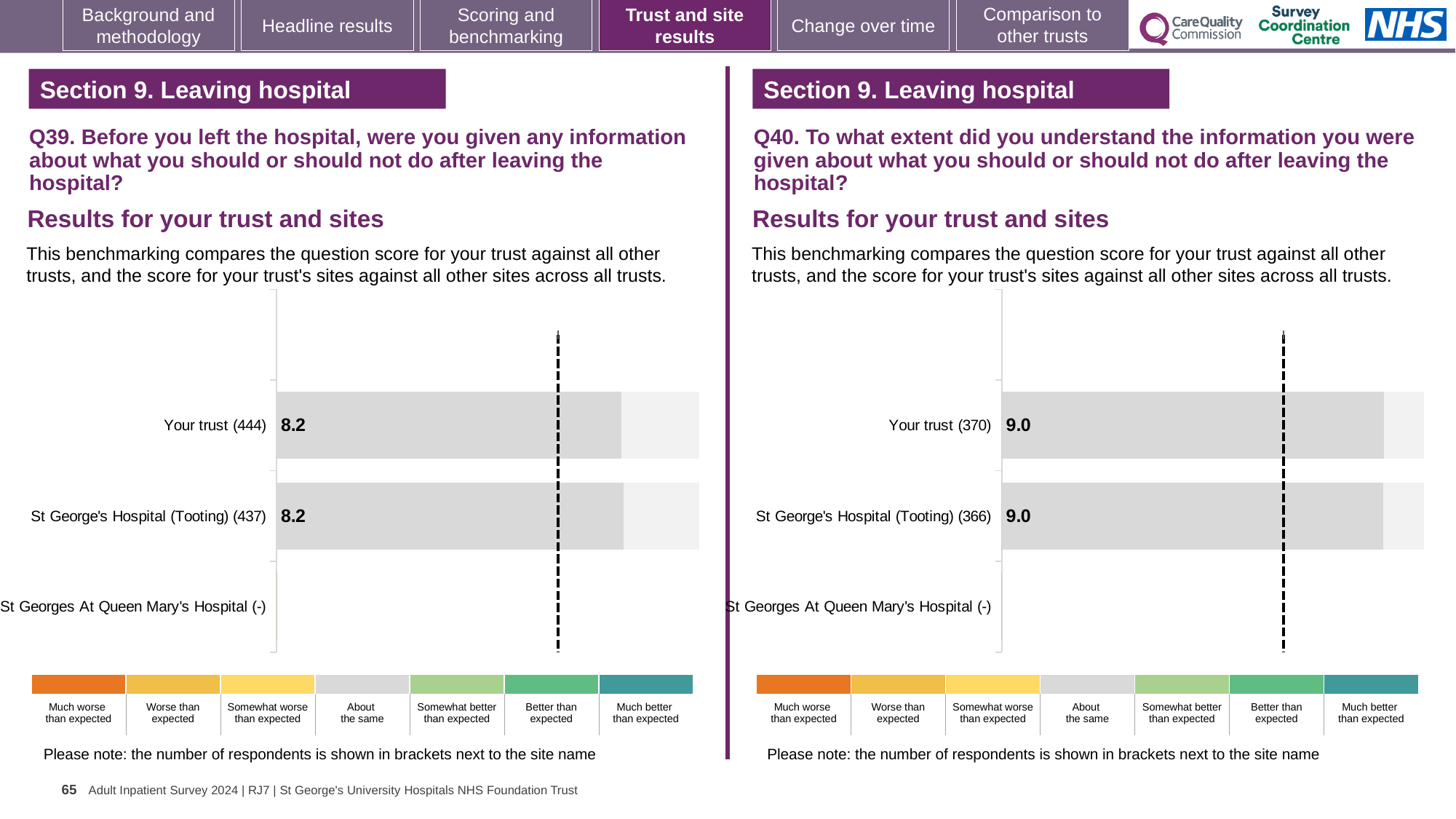
On the Q40 chart (right), what is the score for Your trust? 9.0 How many categories are listed on the Q39 chart (left)? 3 On the Q40 chart (right), what is the score for St George's Hospital (Tooting)? 9.0 On the Q39 chart (left), what is the difference between the score for Your trust and the score for St George's Hospital (Tooting)? 0.0 On the Q39 chart (left), which category has no bar plotted? St Georges At Queen Mary's Hospital (-) On the Q40 chart (right), how many respondents are shown in brackets for St George's Hospital (Tooting)? 366 On the Q40 chart (right), what is the difference between the score for Your trust and the score for St George's Hospital (Tooting)? 0.0 On the Q39 chart (left), what is the score for Your trust? 8.2 On the Q39 chart (left), how many respondents are shown in brackets for Your trust? 444 How many benchmark bands are shown in the colour key below the Q40 chart (right)? 7 What kind of chart is used on the Q40 chart (right)? bar chart On the Q39 chart (left), what is the score for St George's Hospital (Tooting)? 8.2